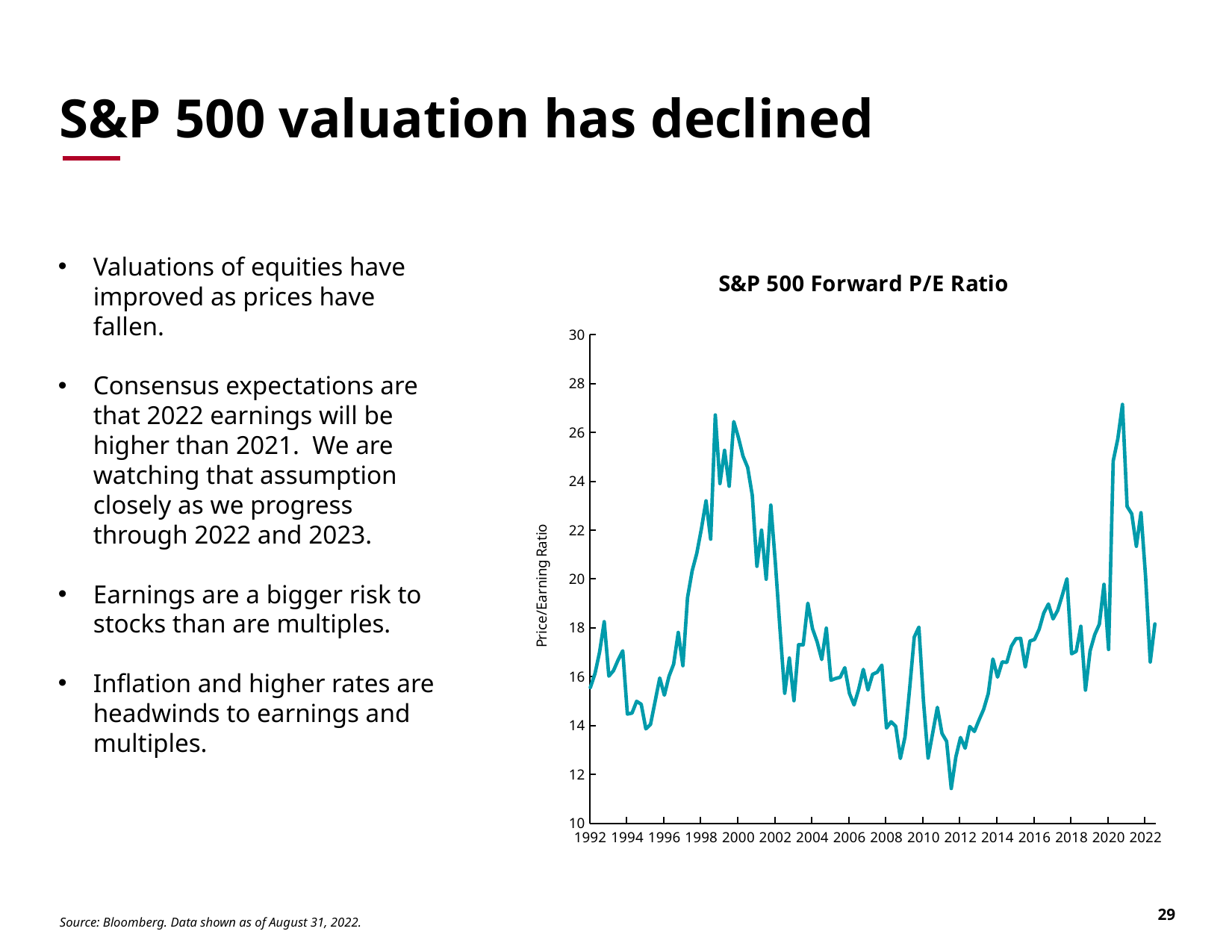
How many year labels are shown on the horizontal axis of the chart? 16 What is the title of the chart? S&P 500 Forward P/E Ratio What is the label on the vertical axis of the chart? Price/Earning Ratio Is the S&P 500 Forward P/E Ratio higher in 2000 or in 2012? 2000 Is the lowest value of the S&P 500 Forward P/E Ratio, around 2011, greater or less than 12? less Around which year does the S&P 500 Forward P/E Ratio reach its lowest point? 2011 What kind of chart is shown on the slide? line chart Is the S&P 500 Forward P/E Ratio in 1995 greater or less than 16? less Is the S&P 500 Forward P/E Ratio in 2000 greater or less than 24? greater Does the S&P 500 Forward P/E Ratio rise or fall between 2012 and 2018? rise Does the S&P 500 Forward P/E Ratio rise or fall between 2000 and 2002? fall